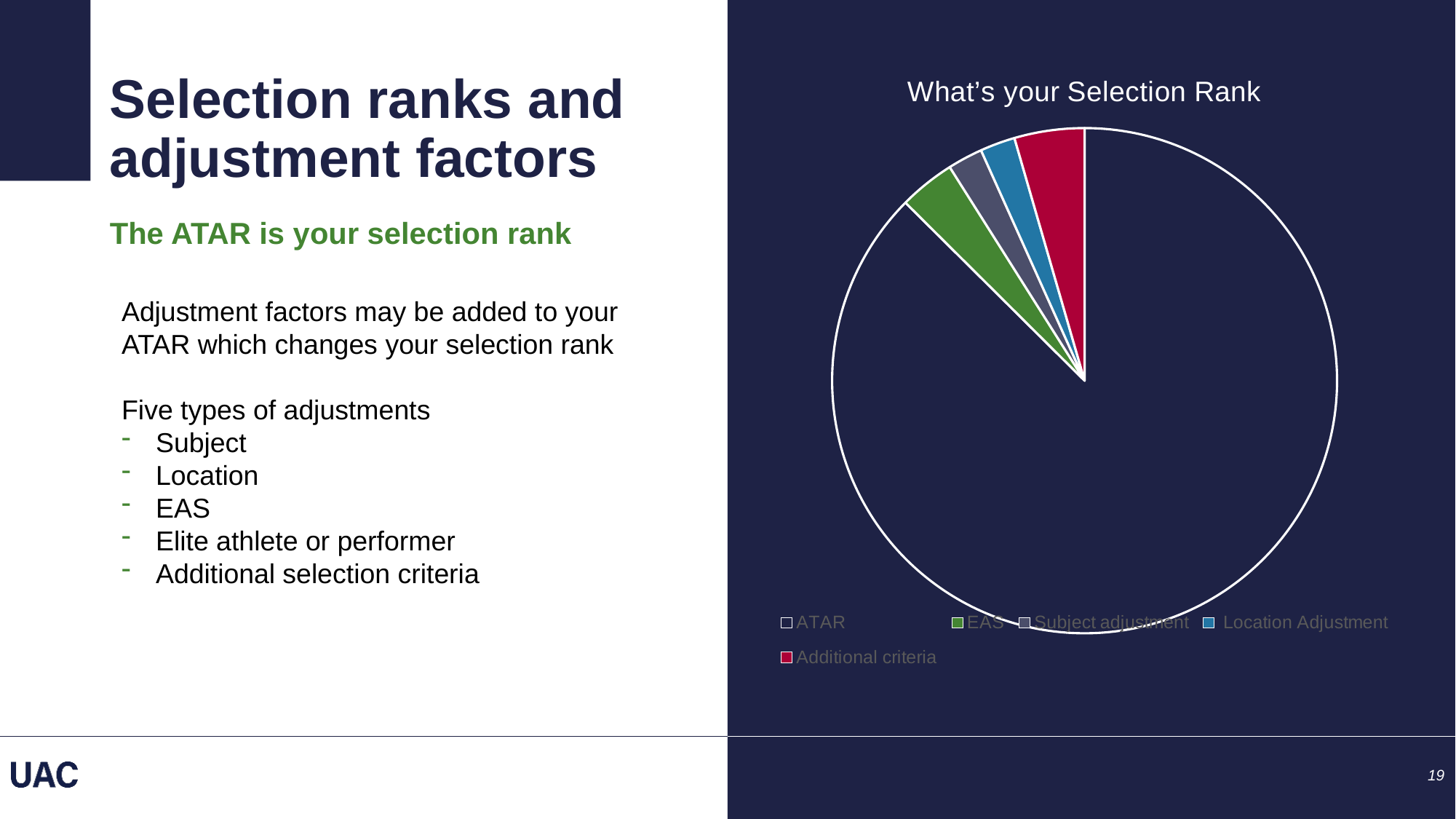
Which slice is larger, ATAR or Additional criteria? ATAR What is the title of the chart? What's your Selection Rank What colour is the EAS slice in the pie chart? green Which slice is larger, ATAR or Location Adjustment? ATAR Which category has the largest slice of the pie? ATAR Which slice is larger, EAS or Subject adjustment? EAS How many categories does the pie chart's legend list? 5 What kind of chart is shown on the slide? pie chart